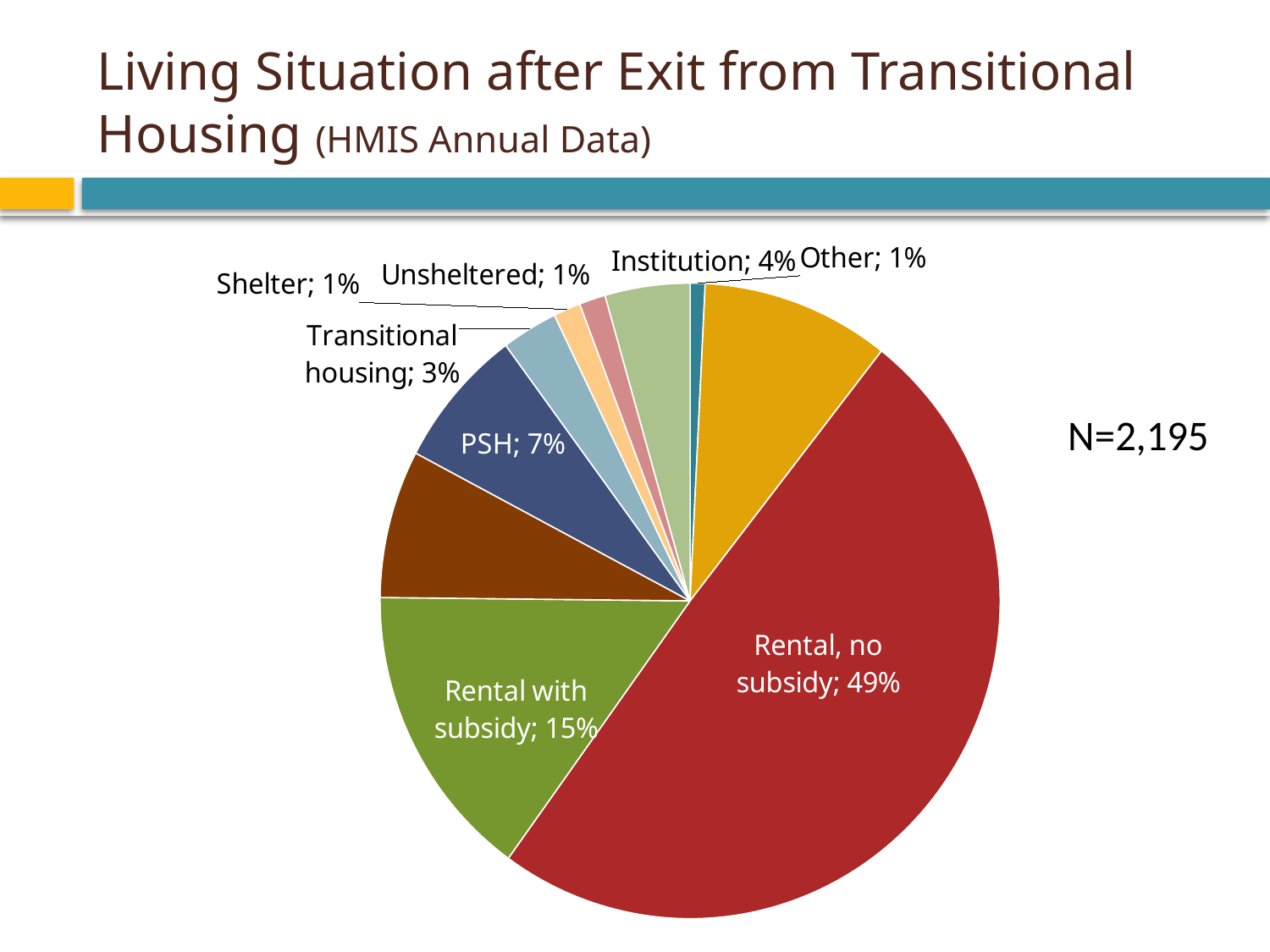
Which is larger, the share for PSH or the share for Institution? PSH What percentage is shown for Transitional housing? 3% What percentage is shown for Institution? 4% Which labeled living situation has the largest share of the pie? Rental, no subsidy What is the total N reported on the slide? N=2,195 What is the difference in percentage points between Rental, no subsidy and Rental with subsidy? 34 What share of exits went to Rental with subsidy? 15% What data source is named in the slide title? HMIS Annual Data What percentage is shown for PSH? 7% What kind of chart is shown on the slide? pie chart What percentage is shown for Shelter? 1% What share of exits went to Rental, no subsidy? 49%